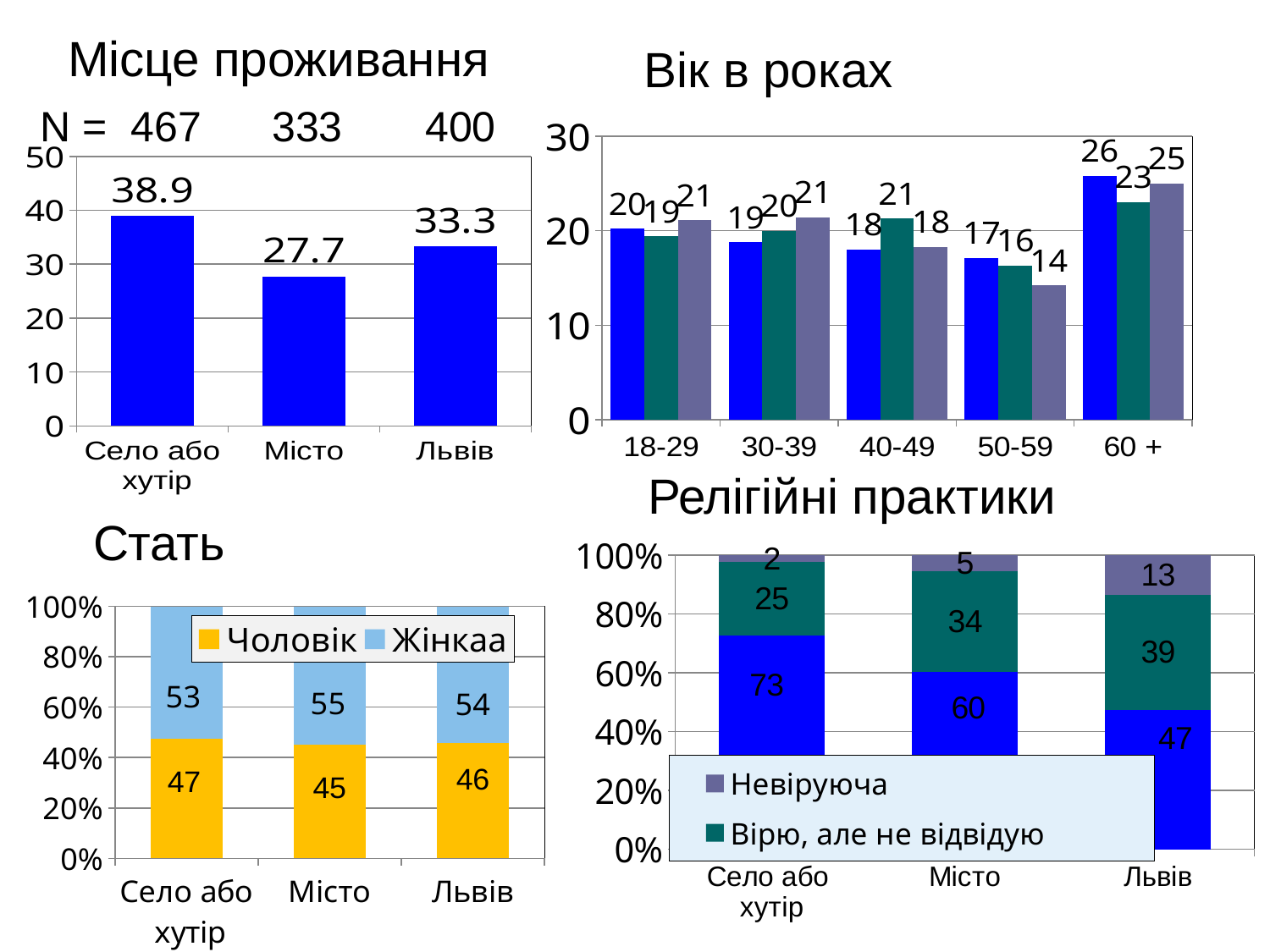
In the 'Місце проживання' chart, which category has the highest value? Село або хутір In the 'Релігійні практики' chart, what is the value for 'Вірю, але не відвідую' in Львів? 39 In the 'Місце проживання' chart, what is the value for Місто? 27.7 In the 'Вік в роках' chart, what is the value of the blue bar for the 60 + category? 26 How many age categories are shown on the x axis of the 'Вік в роках' chart? 5 In the 'Релігійні практики' chart, which category has the highest value for 'Невіруюча'? Львів In the 'Місце проживання' chart, what is the difference between the values for Село або хутір and Львів? 5.6 In the 'Стать' chart, what is the value for Чоловік in Місто? 45 What type of chart is the 'Вік в роках' chart? bar chart How many categories are shown in the 'Місце проживання' chart? 3 In the 'Вік в роках' chart, what is the value of the grey bar for the 50-59 category? 14 How many series does the legend of the 'Стать' chart list? 2